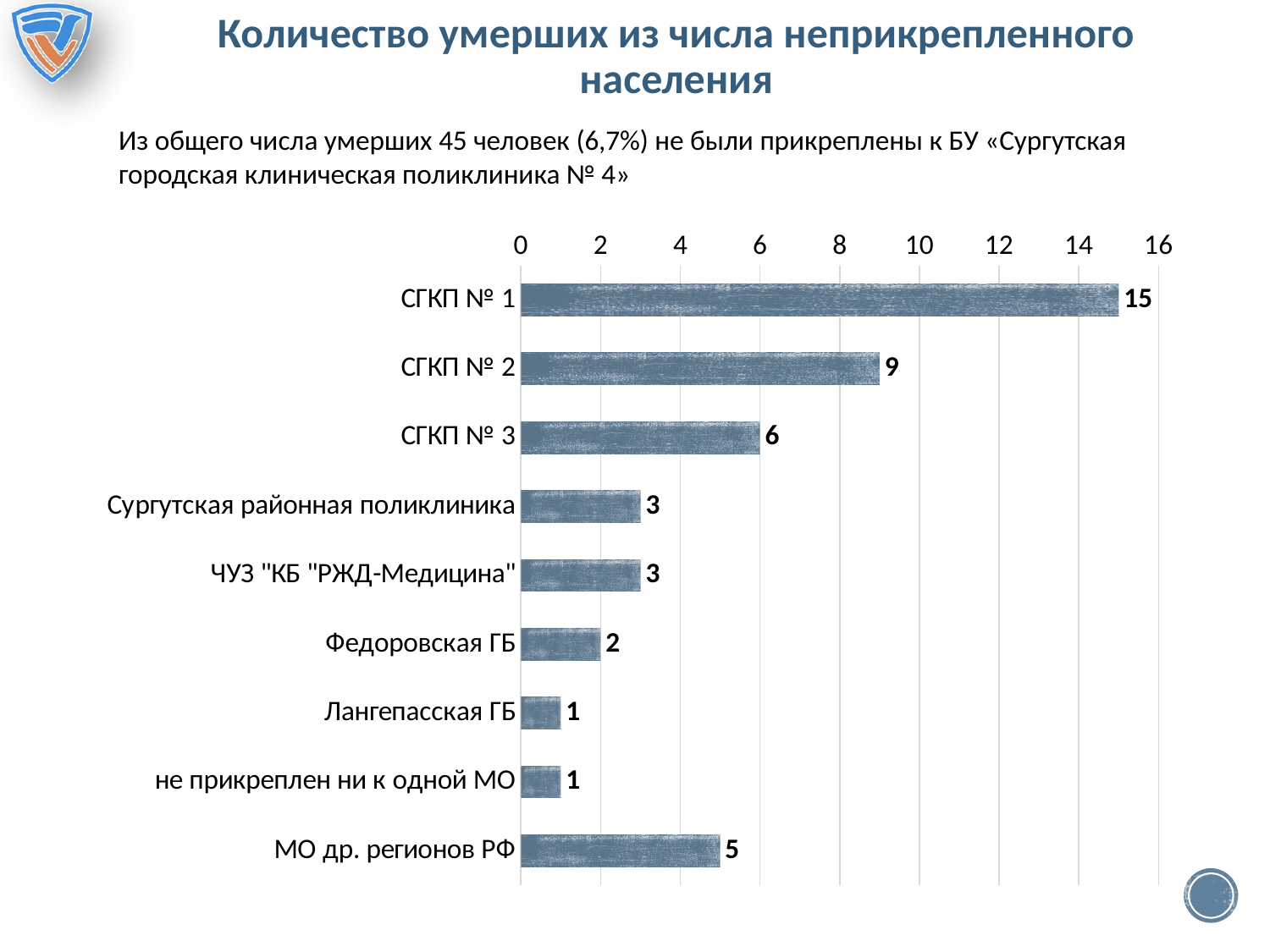
What is the highest value shown on the axis of the chart? 16 What is the difference between the values for СГКП № 3 and Федоровская ГБ? 4 What is the value for Сургутская районная поликлиника? 3 Which is larger, the value for СГКП № 3 or the value for МО др. регионов РФ? СГКП № 3 Which category has the highest value? СГКП № 1 What is the value for МО др. регионов РФ? 5 What is the difference between the values for СГКП № 1 and СГКП № 2? 6 What is the value for Лангепасская ГБ? 1 What is the value for СГКП № 1? 15 What kind of chart is shown on the slide? bar chart How many categories are shown in the chart? 9 Is the value for СГКП № 2 greater or less than 8? greater